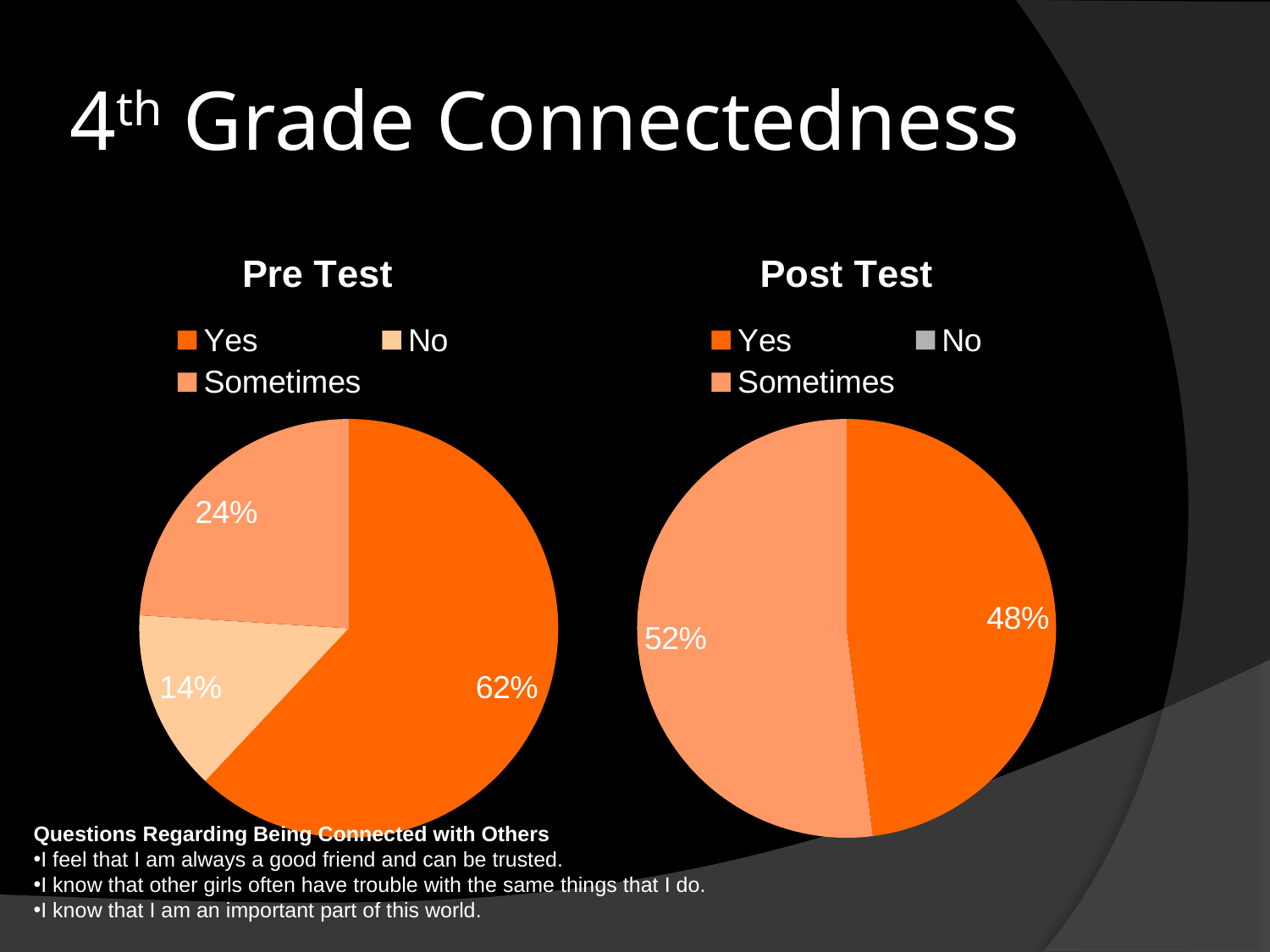
In the Post Test chart, what percentage answered Sometimes? 52% In the Post Test chart, which response has the larger share, Yes or Sometimes? Sometimes In the Pre Test chart, what percentage answered Sometimes? 24% In the Pre Test chart, which response has the largest share? Yes What type of chart is the Pre Test chart? Pie chart In the Pre Test chart, what percentage answered No? 14% In the Post Test chart, what percentage answered Yes? 48% In the Pre Test chart, what is the difference between the Yes share and the Sometimes share? 38% In the Pre Test chart, which response has the smallest share? No In the Pre Test chart, what percentage answered Yes? 62% How many entries does the legend of the Post Test chart list? 3 What is the difference between the Yes share in the Pre Test chart and the Yes share in the Post Test chart? 14%